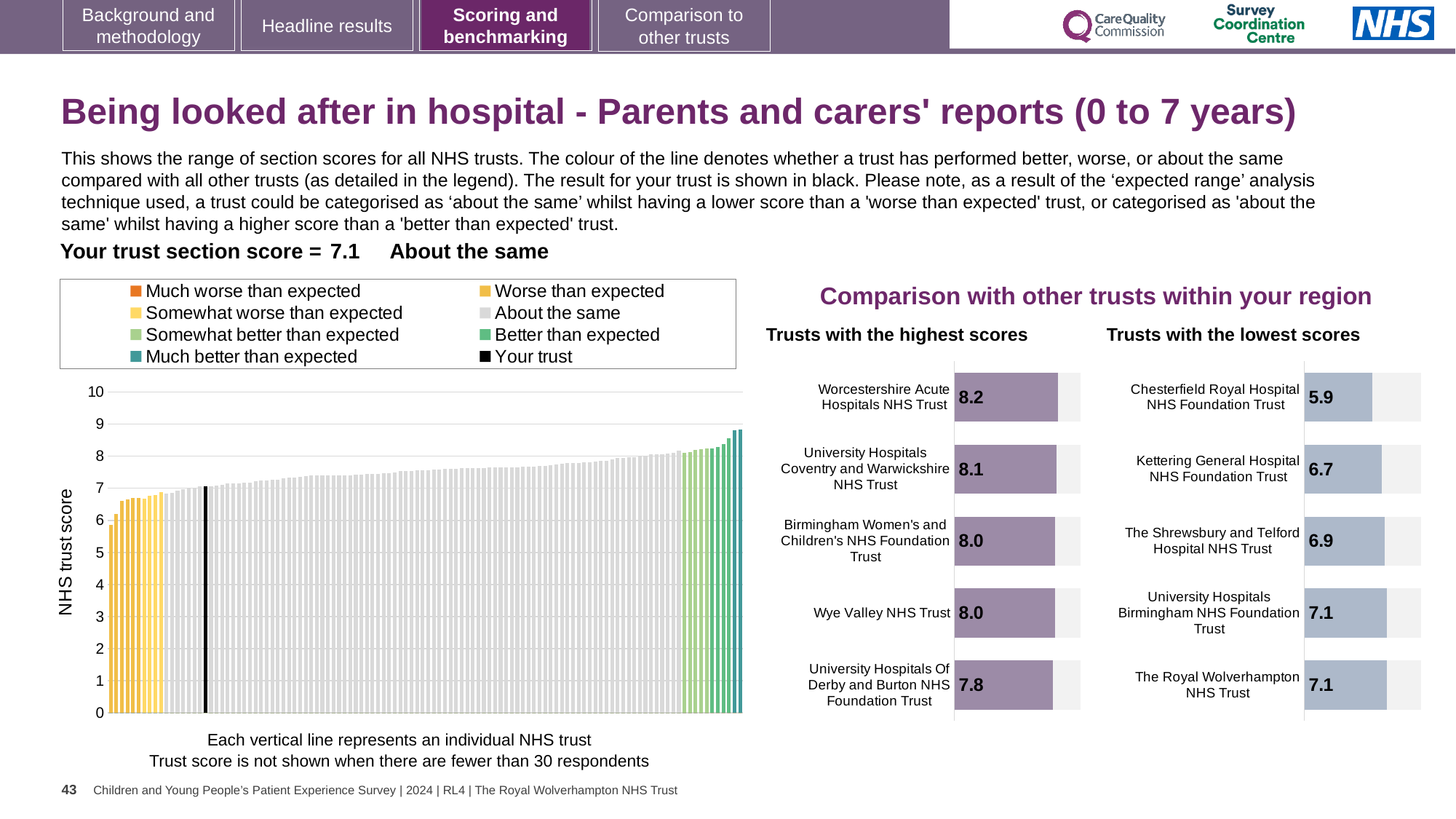
In the 'Trusts with the lowest scores' chart, which trust has the lowest score? Chesterfield Royal Hospital NHS Foundation Trust In the 'Trusts with the lowest scores' chart, what is the score for Chesterfield Royal Hospital NHS Foundation Trust? 5.9 In the 'Trusts with the highest scores' chart, which trust has the highest score? Worcestershire Acute Hospitals NHS Trust In the 'Trusts with the highest scores' chart, what is the difference between the scores of Worcestershire Acute Hospitals NHS Trust and University Hospitals Of Derby and Burton NHS Foundation Trust? 0.4 In the large 'NHS trust score' chart on the left, is the value of the black 'Your trust' bar greater or less than 5? greater In the large 'NHS trust score' chart on the left, do the bar values rise or fall from left to right? Rise How many trusts are shown in the 'Trusts with the highest scores' chart? 5 In the 'Trusts with the lowest scores' chart, which has the higher score: Kettering General Hospital NHS Foundation Trust or The Shrewsbury and Telford Hospital NHS Trust? The Shrewsbury and Telford Hospital NHS Trust In the 'Trusts with the lowest scores' chart, how much higher is Kettering General Hospital NHS Foundation Trust's score than Chesterfield Royal Hospital NHS Foundation Trust's? 0.8 How many entries does the legend above the large 'NHS trust score' chart list? 8 In the 'Trusts with the highest scores' chart, what is the score for Worcestershire Acute Hospitals NHS Trust? 8.2 What kind of chart is the large chart on the left with the 'NHS trust score' axis? Bar chart